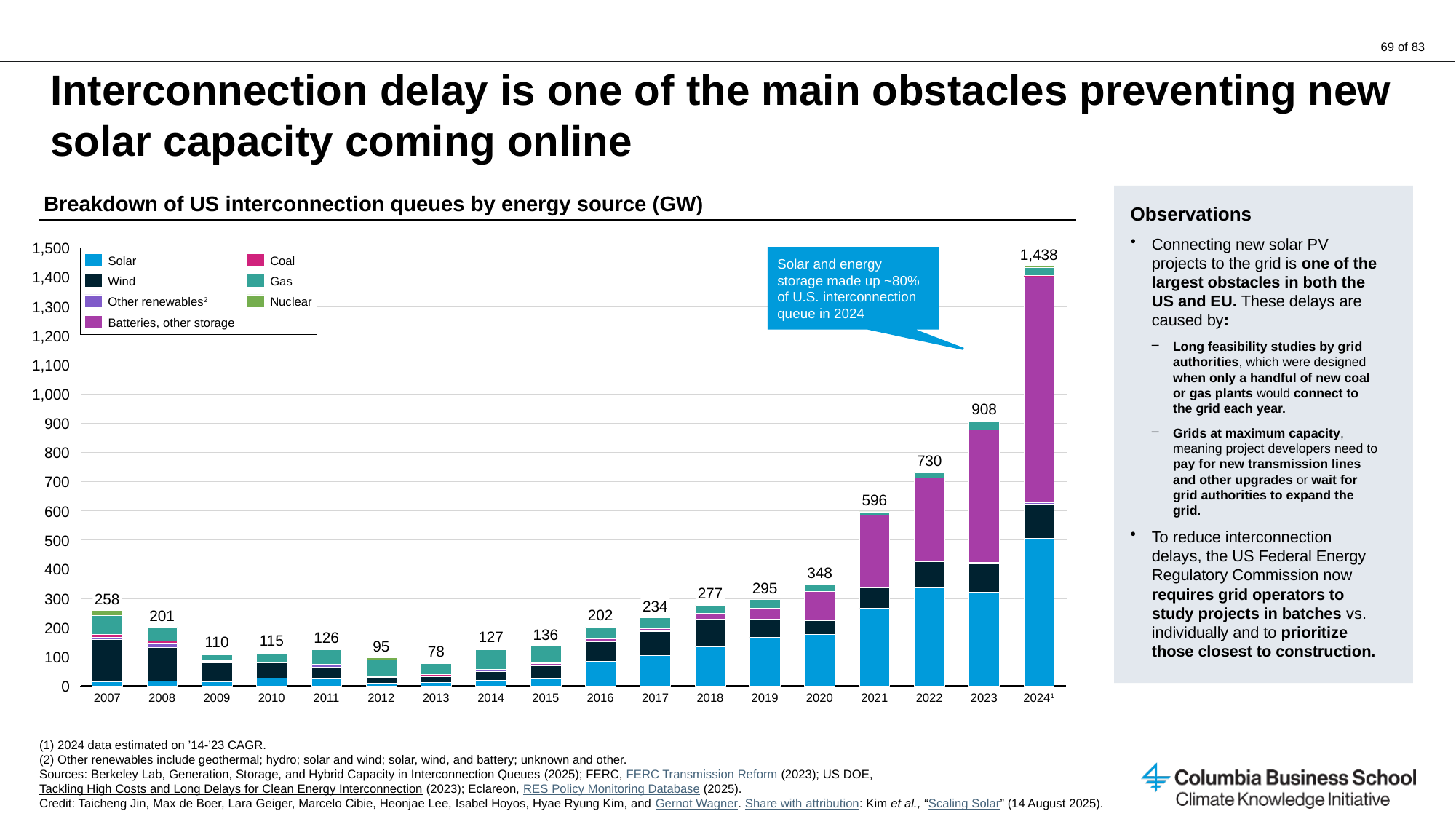
What is the total value labeled for 2007? 258 Which year has the highest total interconnection queue? 2024 What is the difference between the 2024 total and the 2023 total? 530 Which is larger, the total for 2021 or the total for 2020? 2021 How many energy sources does the legend list? 7 What is the difference between the 2007 total and the 2008 total? 57 Which year has the lowest total interconnection queue? 2013 Is the Solar segment for 2023 greater or less than 300? greater What is the total interconnection queue value shown for 2024? 1,438 What kind of chart is used to show the breakdown of US interconnection queues? Stacked bar chart What is the total value labeled for 2023? 908 How many years are shown on the x axis? 18